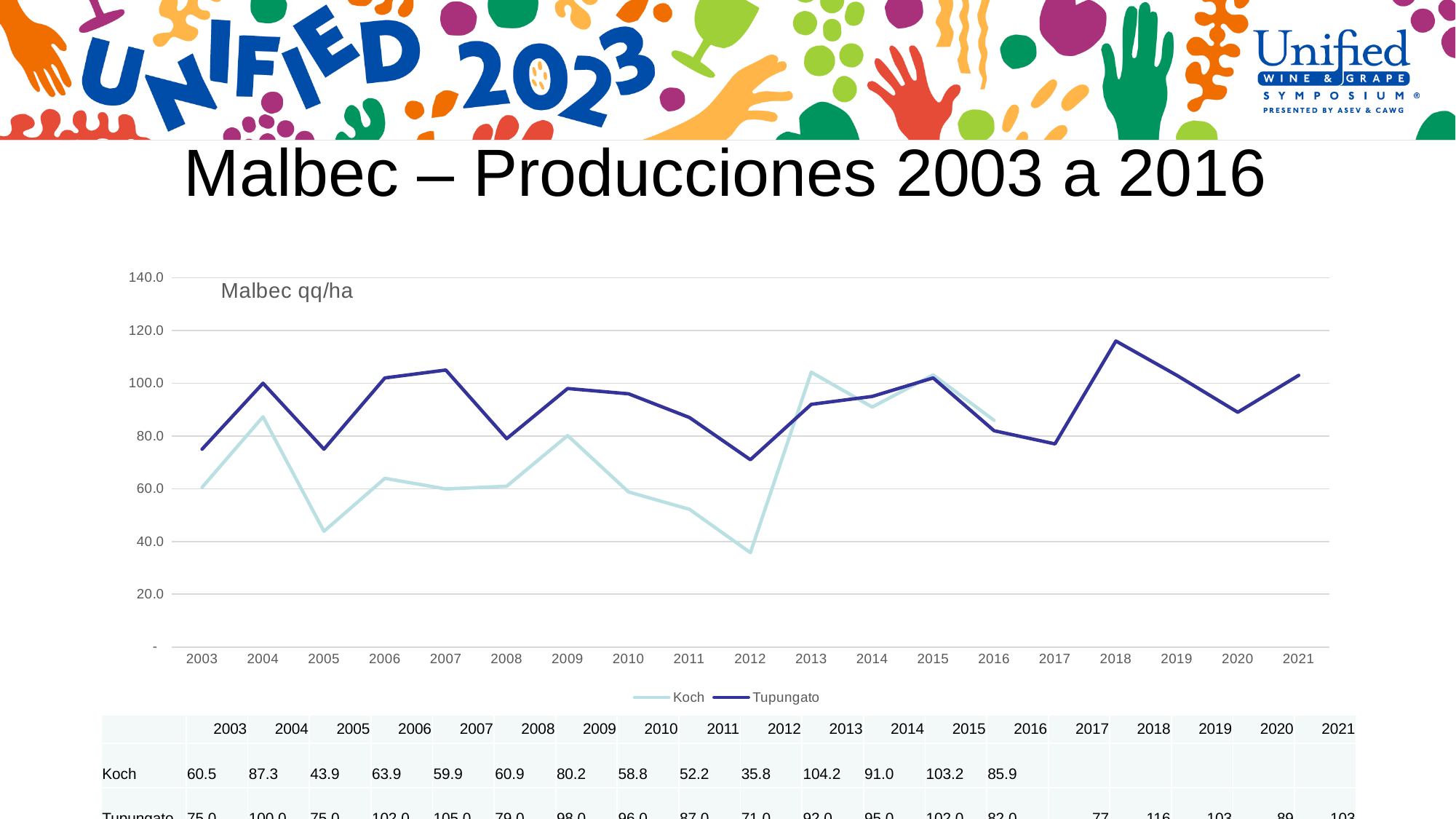
What is the Koch value for 2005? 43.9 How many series does the legend list? 2 Is the Tupungato value for 2018 greater or less than 100.0? greater Is the Tupungato value for 2017 greater or less than 80.0? less In which year is the Koch series at its highest? 2013 In which year is the Koch series at its lowest? 2012 What is the title shown inside the chart area? Malbec qq/ha What is the Koch value for 2012? 35.8 What is the Koch value for 2013? 104.2 Which series has the larger value in 2012, Koch or Tupungato? Tupungato What type of chart is shown on the slide? line chart What is the difference between the Koch values for 2013 and 2012? 68.4